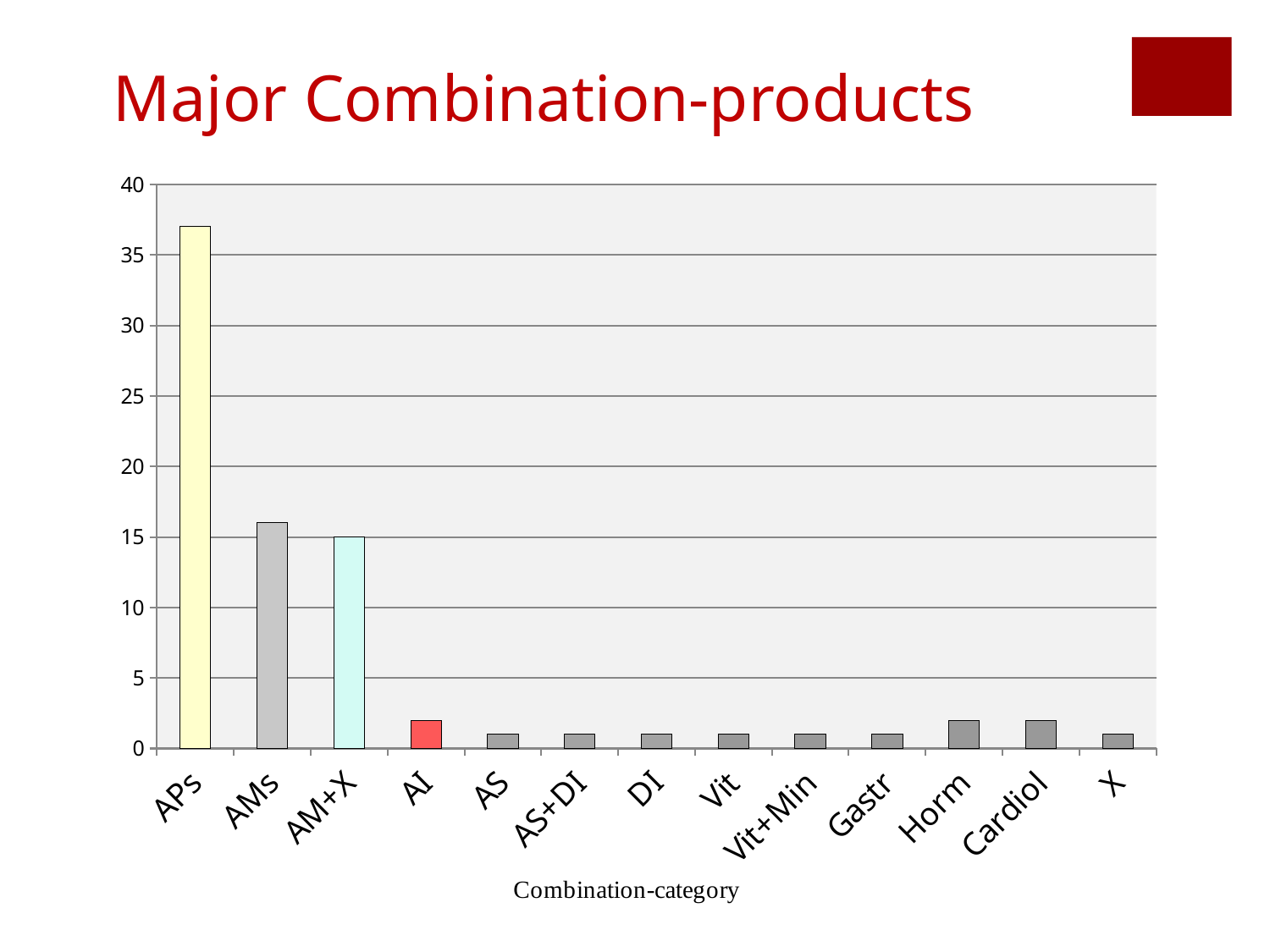
Which has the larger value, AI or AS? AI Is the value for AM+X greater or less than 10? greater Is the value for AI greater or less than 5? less Is the value for AMs greater or less than 20? less Which combination category has the highest value? APs What is the label of the x axis? Combination-category Which has the larger value, APs or AMs? APs How many combination categories are plotted on the x axis? 13 What kind of chart is shown on the slide? bar chart Do the values generally rise or fall moving from left to right along the x axis? fall What is the title of the slide containing the chart? Major Combination-products